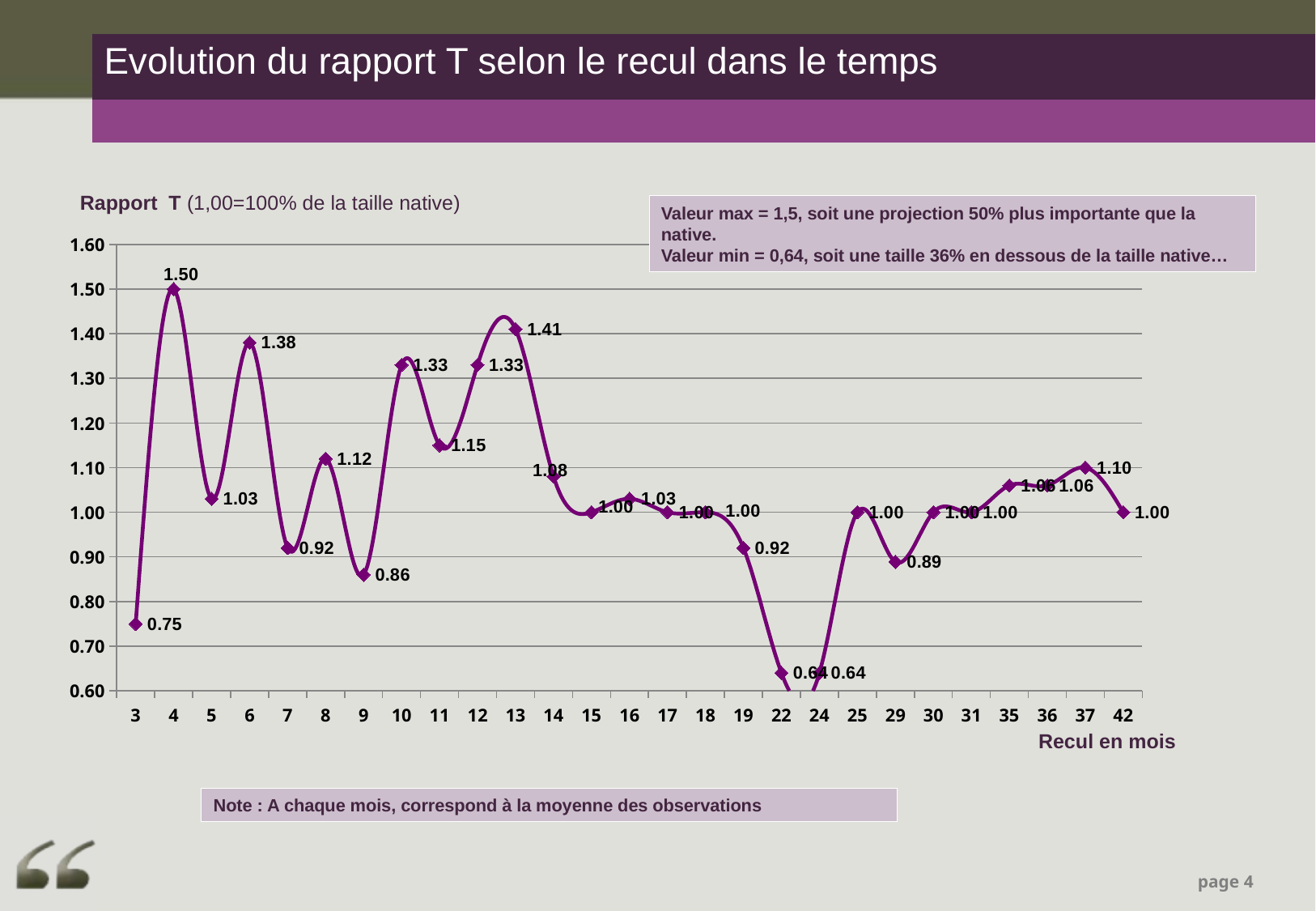
How many data points are plotted on the chart? 27 What is the label of the x axis of the chart? Recul en mois Is the value of Rapport T at 22 months greater or less than 0.70? less What kind of chart is shown on the slide? Line chart What is the value of Rapport T at 4 months of recul? 1.50 What is the value of Rapport T at 42 months? 1.00 What is the difference between the Rapport T values at 4 months and at 3 months? 0.75 What is the lowest value of Rapport T shown on the chart? 0.64 What is the value of Rapport T at 9 months? 0.86 What is the value of Rapport T at 13 months? 1.41 Which has a larger Rapport T value: 6 months or 13 months? 13 months At which recul (in months) is Rapport T highest? 4